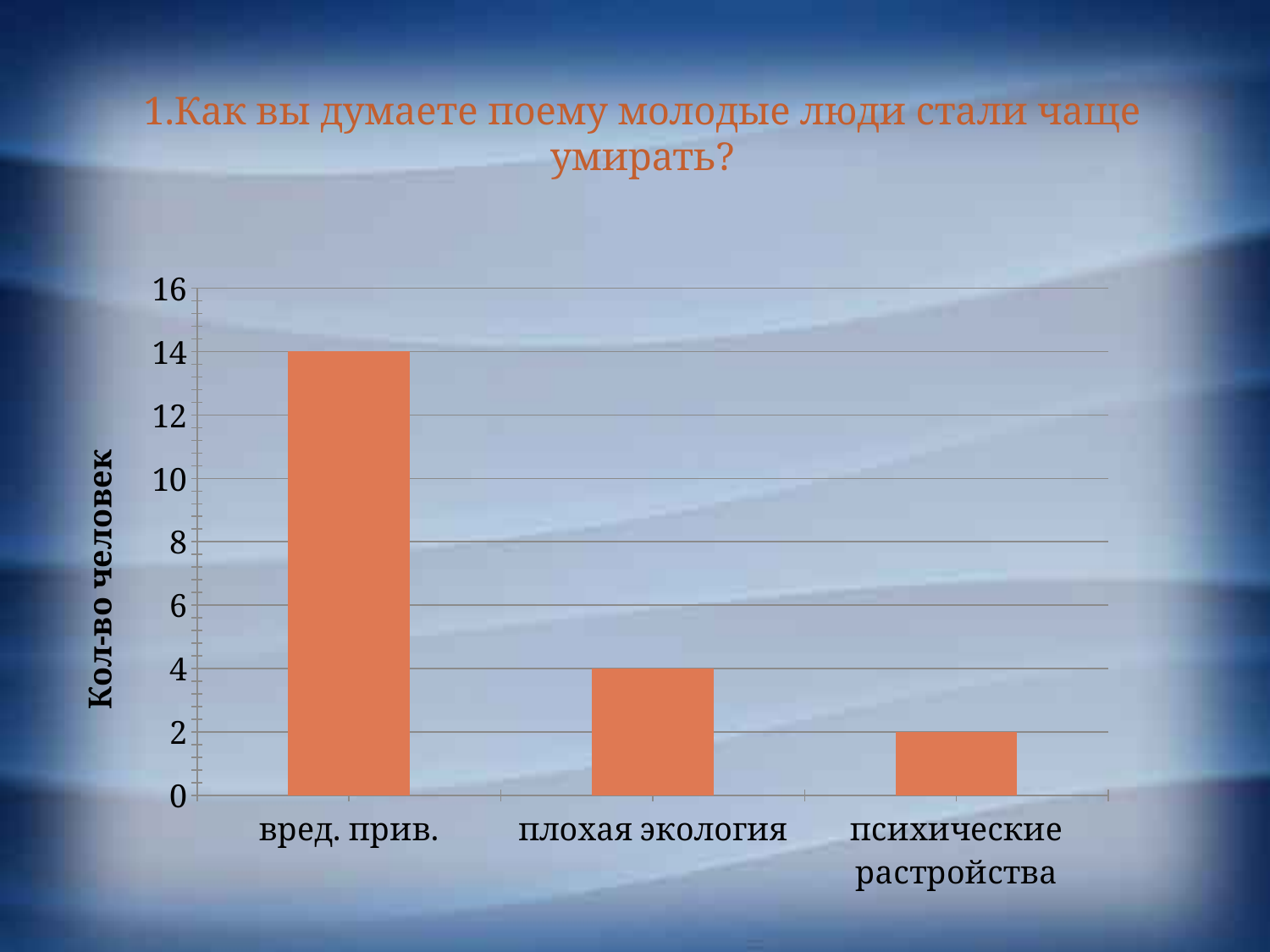
What is the value for плохая экология? 4 Which category has the lowest value? психические растройства What is the difference between the values for плохая экология and психические растройства? 2 Is the value for вред. прив. greater or less than 10? greater Which category has the highest value? вред. прив. What kind of chart is shown on the slide? bar chart Which is larger, the value for плохая экология or the value for психические растройства? плохая экология How many categories are shown on the chart? 3 What is the difference between the values for вред. прив. and плохая экология? 10 What is the value for вред. прив.? 14 What is the label of the vertical axis? Кол-во человек What is the value for психические растройства? 2